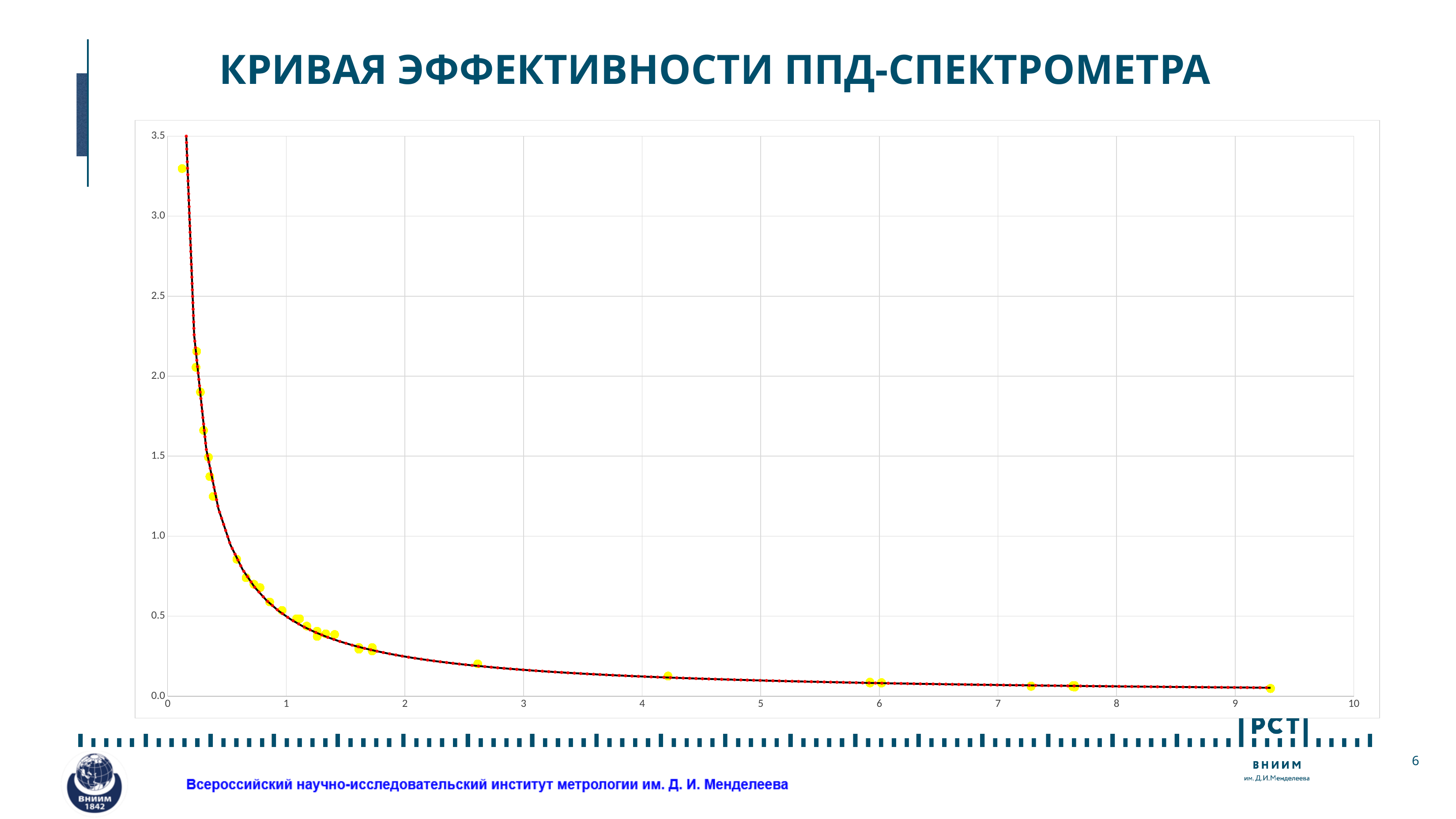
What kind of chart is shown on the slide? Scatter plot with a fitted curve Is the value of the plotted point near x = 2.6 greater or less than 0.5? less Is the value of the plotted point near x = 4.2 greater or less than 1.0? less Is the value of the leftmost plotted point (near x = 0.1) greater or less than 3.0? greater Which plotted point has the higher value: the one near x = 0.1 or the one near x = 7.3? The one near x = 0.1 What is the highest value shown on the horizontal axis? 10 What is the highest value shown on the vertical axis? 3.5 Where along the x axis is the highest plotted value located: near the left end or near the right end? Near the left end Where along the x axis is the lowest plotted value located: near the left end or near the right end? Near the right end What is the title of the chart on the slide? КРИВАЯ ЭФФЕКТИВНОСТИ ППД-СПЕКТРОМЕТРА Do the plotted values rise or fall as the x value increases? Fall